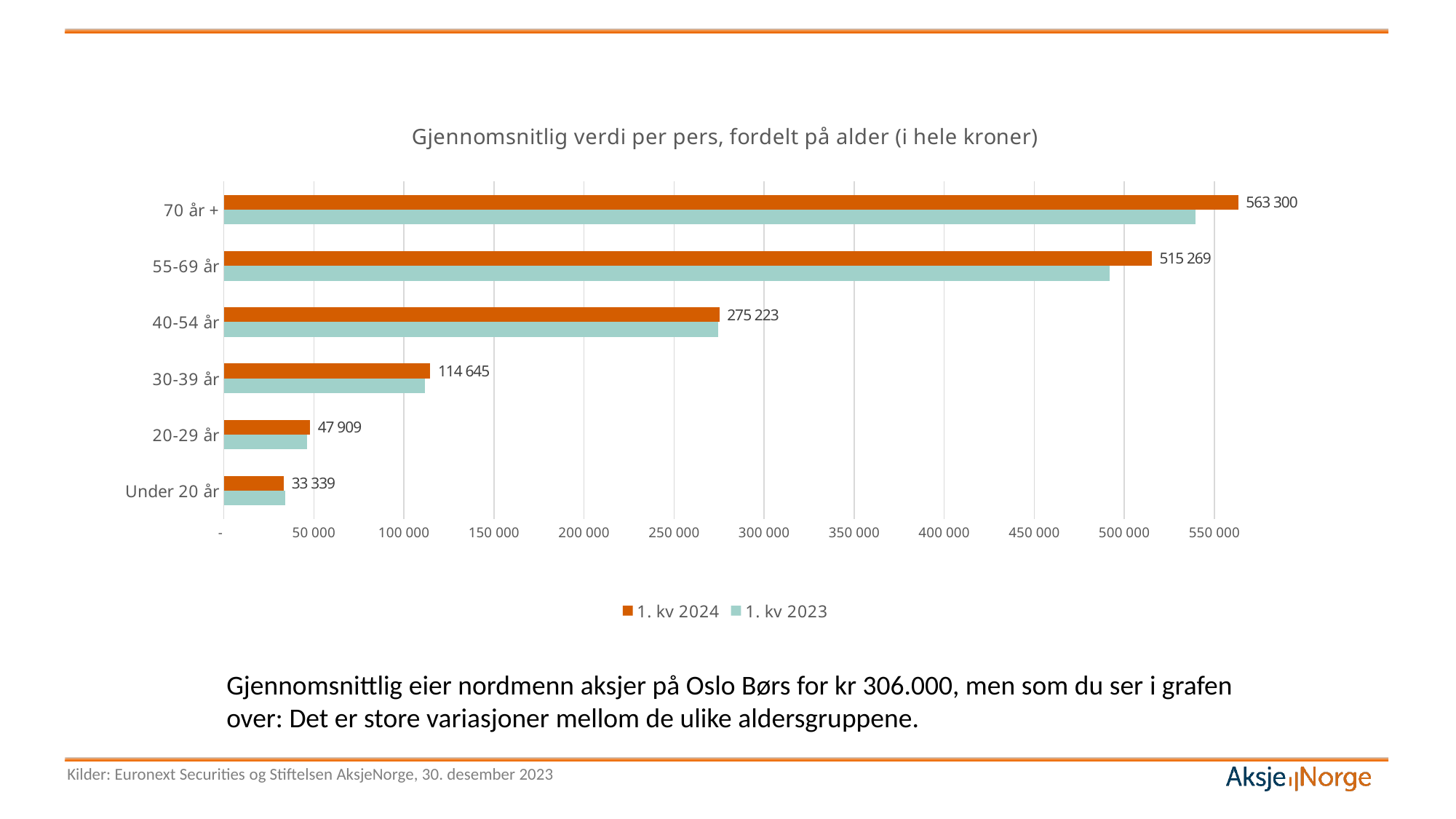
Is the 1. kv 2023 value for 70 år + greater or less than 500 000? greater Which age group has the highest value in the 1. kv 2024 series? 70 år + Which age group has the lowest value in the 1. kv 2024 series? Under 20 år What is the value for 20-29 år in the 1. kv 2024 series? 47 909 What is the value for 40-54 år in the 1. kv 2024 series? 275 223 What is the value for 70 år + in the 1. kv 2024 series? 563 300 Which is larger in the 1. kv 2024 series: 30-39 år or 20-29 år? 30-39 år What is the difference between the 1. kv 2024 values for 70 år + and 55-69 år? 48 031 What kind of chart is shown on the slide? Bar chart Is the 1. kv 2023 value for 55-69 år greater or less than 500 000? less How many series does the legend list? 2 How many age groups are shown on the chart? 6